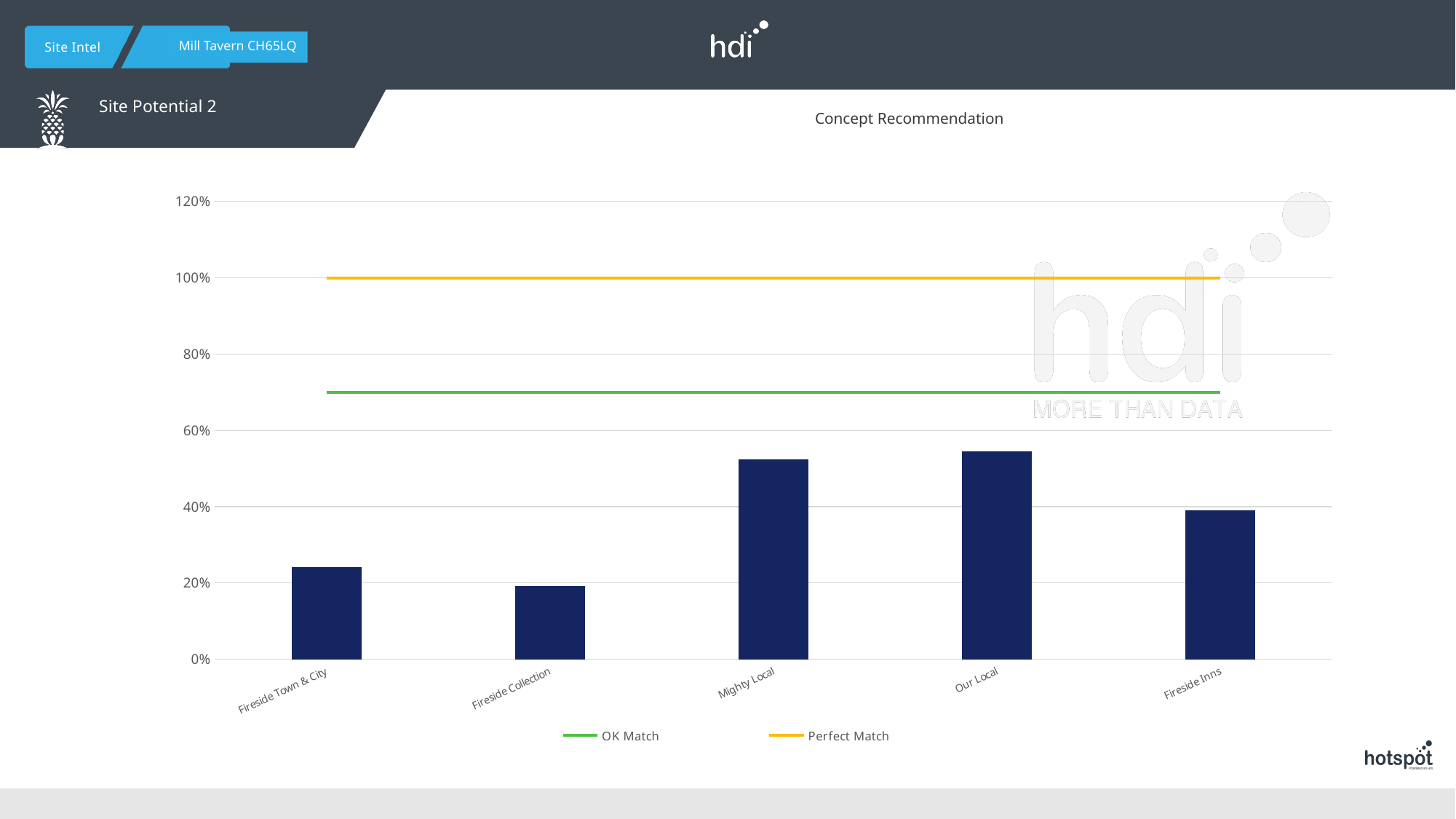
Is the value for Mighty Local greater or less than 40%? greater Is the OK Match line greater or less than 80%? less How many series does the legend list? 2 Is the value for Fireside Town & City greater or less than 20%? greater At what level is the Perfect Match line drawn? 100% Which is larger, the value for Mighty Local or the value for Fireside Inns? Mighty Local Which is larger, the value for Fireside Town & City or the value for Fireside Collection? Fireside Town & City Which concept has the lowest bar? Fireside Collection How many concept categories are plotted on the x axis? 5 What kind of chart is shown on the slide? bar chart What is the title of the chart? Concept Recommendation